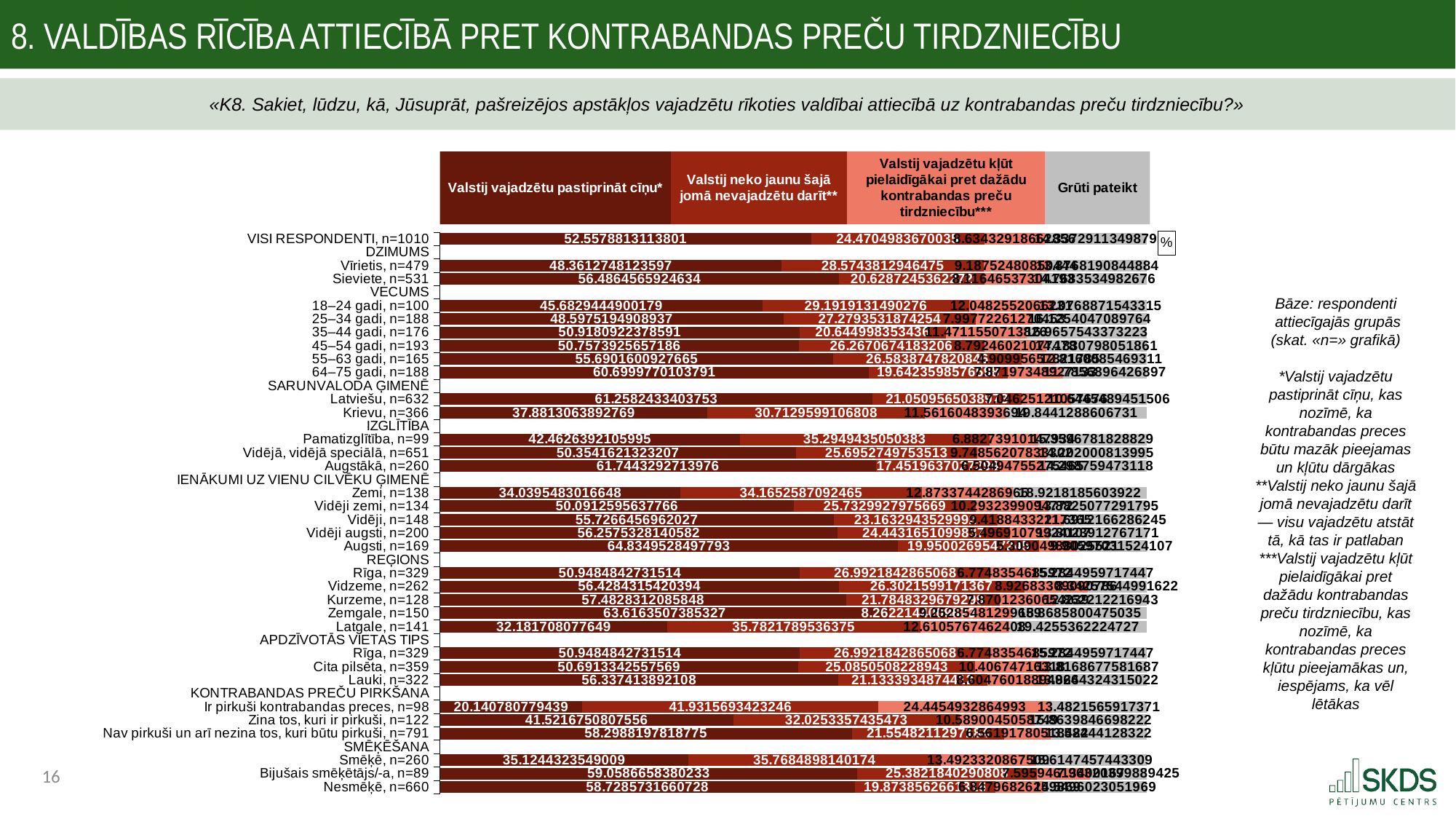
Which category has the highest value for "Valstij vajadzētu pastiprināt cīņu*"? Augsti, n=169 What is the difference between the "Valstij vajadzētu pastiprināt cīņu*" values for "Sieviete, n=531" and "Vīrietis, n=479"? 8.1251817801037 What is the value of "Valstij vajadzētu pastiprināt cīņu*" for "Krievu, n=366"? 37.8813063892769 What is the value of "Grūti pateikt" for "Ir pirkuši kontrabandas preces, n=98"? 13.4821565917371 What is the total of the stacked bar for "Ir pirkuši kontrabandas preces, n=98"? 100 Which legend entry is shown in the lightest red/salmon colour? Valstij vajadzētu kļūt pielaidīgākai pret dažādu kontrabandas preču tirdzniecību*** Which has the larger value for "Valstij vajadzētu pastiprināt cīņu*": "Latviešu, n=632" or "Krievu, n=366"? Latviešu, n=632 Which category has the lowest value for "Valstij vajadzētu pastiprināt cīņu*"? Ir pirkuši kontrabandas preces, n=98 How many series does the legend list? 4 What is the value of "Valstij vajadzētu pastiprināt cīņu*" for "VISI RESPONDENTI, n=1010"? 52.5578813113801 What kind of chart is shown on the slide? Stacked bar chart What is the value of "Valstij neko jaunu šajā jomā nevajadzētu darīt**" for "Ir pirkuši kontrabandas preces, n=98"? 41.9315693423246